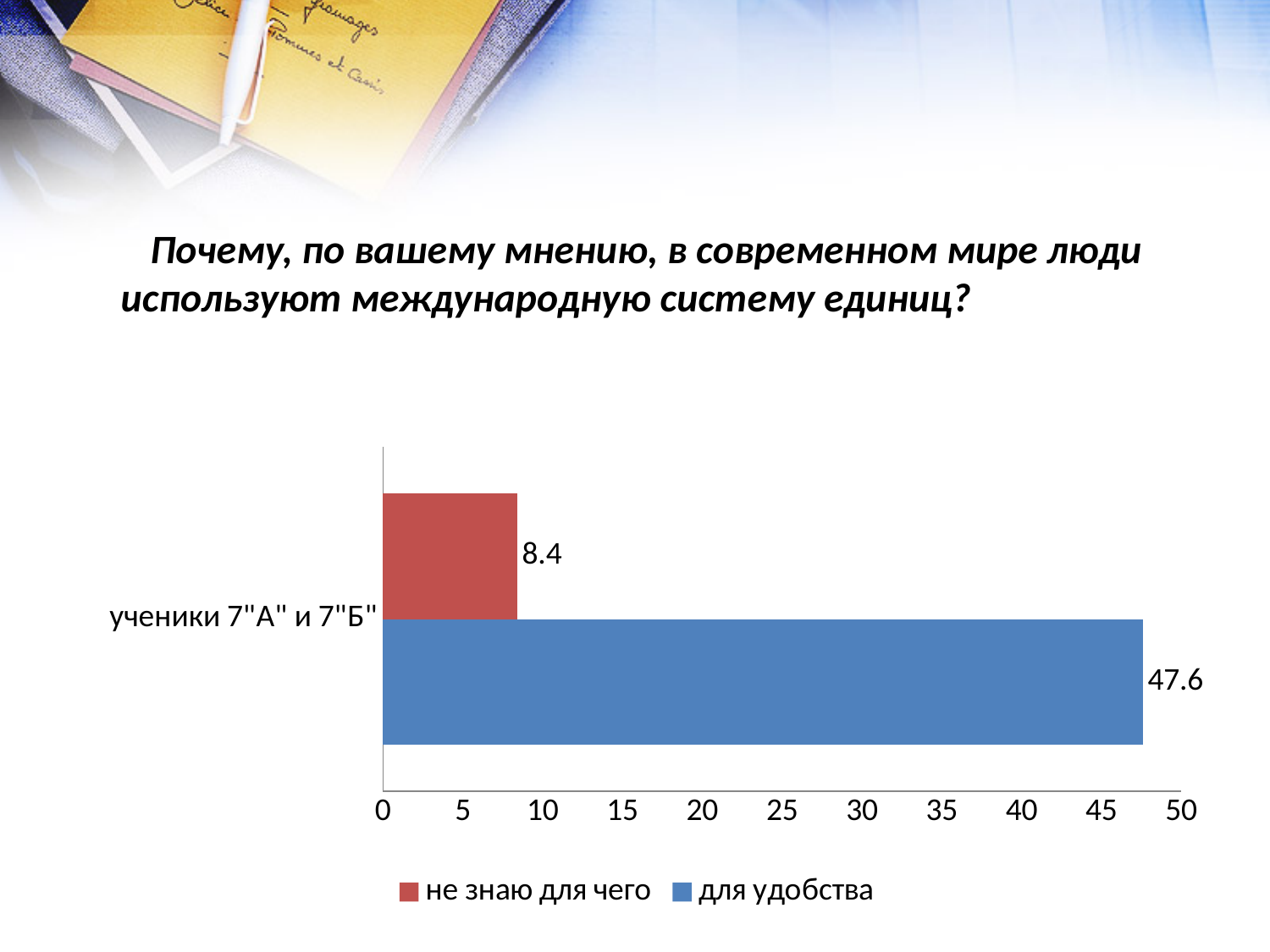
Is the value for "для удобства" greater or less than 45? greater What is the label of the category on the vertical axis? ученики 7"А" и 7"Б" How many categories are shown on the vertical axis? 1 What is the difference between the values for "для удобства" and "не знаю для чего"? 39.2 What is the value for "не знаю для чего" for ученики 7"А" и 7"Б"? 8.4 What kind of chart is shown on the slide? bar chart What is the maximum value shown on the horizontal axis? 50 What colour is the bar for "не знаю для чего"? red Which series has the higher value: "не знаю для чего" or "для удобства"? для удобства Is the value for "не знаю для чего" greater or less than 10? less How many series does the legend list? 2 What is the value for "для удобства" for ученики 7"А" и 7"Б"? 47.6